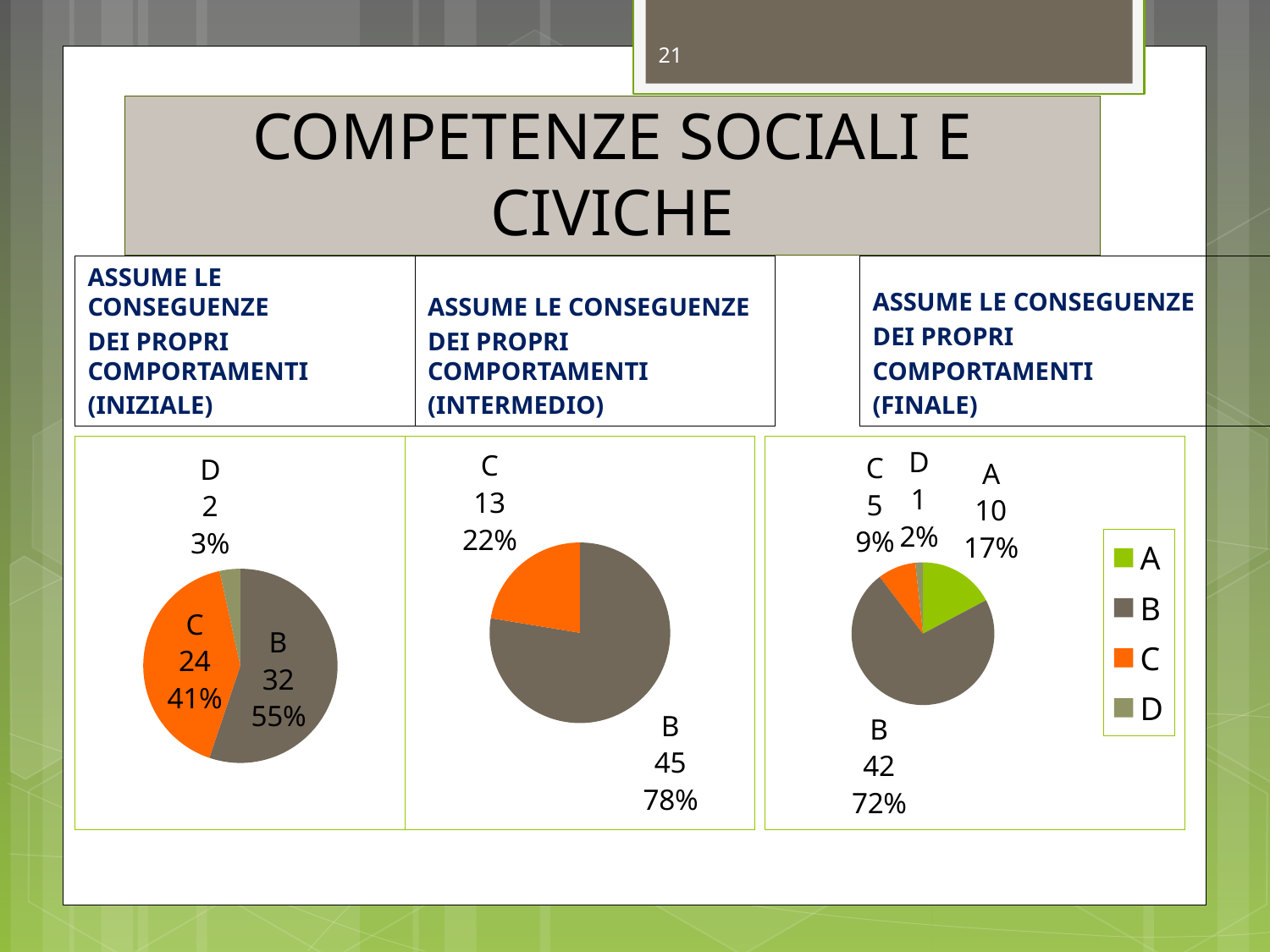
In the INIZIALE pie chart (left), what is the difference between the values for B and C? 8 In the FINALE pie chart (right), which category has the largest slice? B In the INIZIALE pie chart (left), what share of the pie does category C represent? 41% In the INTERMEDIO pie chart (middle), what share of the pie does category B represent? 78% In the FINALE pie chart (right), what is the value for category A? 10 In the INTERMEDIO pie chart (middle), what is the value for category C? 13 In the INIZIALE pie chart (left), what is the value for category B? 32 In the FINALE pie chart (right), which is larger, the value for A or the value for C? A In the INIZIALE pie chart (left), which category has the smallest slice? D How many entries does the legend next to the FINALE pie chart (right) list? 4 How many slices does the INTERMEDIO pie chart (middle) have? 2 What type of chart is used in the INIZIALE chart (left)? Pie chart